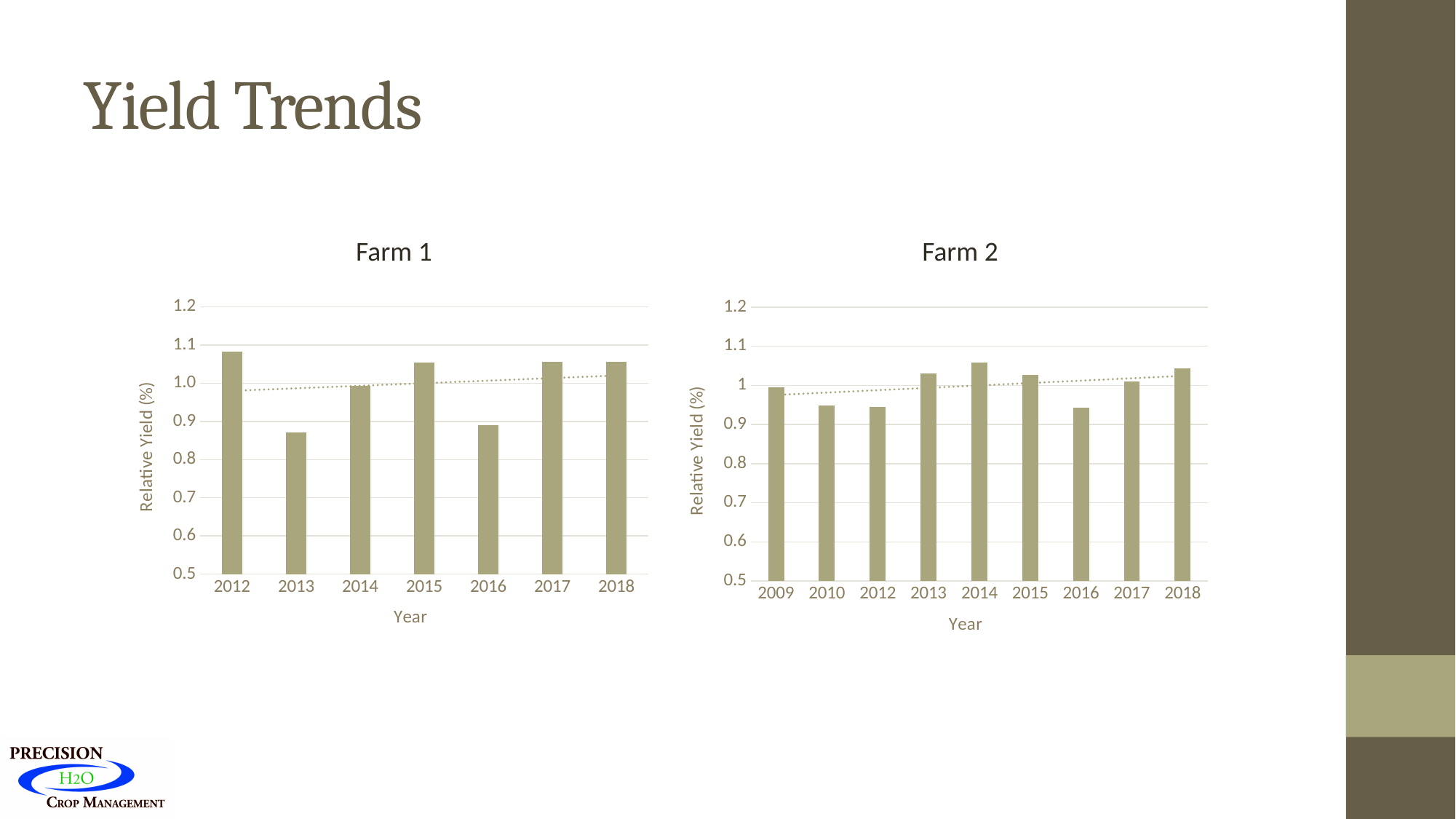
In the Farm 1 chart, is the value for 2012 greater or less than 1.0? greater In the Farm 2 chart, which is larger, the value for 2014 or the value for 2016? 2014 In the Farm 1 chart, which year has the highest relative yield? 2012 In the Farm 1 chart, is the value for 2013 greater or less than 0.9? less In the Farm 1 chart, which is larger, the value for 2012 or the value for 2013? 2012 What is the y-axis title of the Farm 2 chart? Relative Yield (%) How many years are plotted in the Farm 2 chart? 9 How many years are plotted in the Farm 1 chart? 7 What kind of chart is the Farm 1 chart? bar chart In the Farm 2 chart, is the value for 2010 greater or less than 1? less In the Farm 2 chart, which year has the highest relative yield? 2014